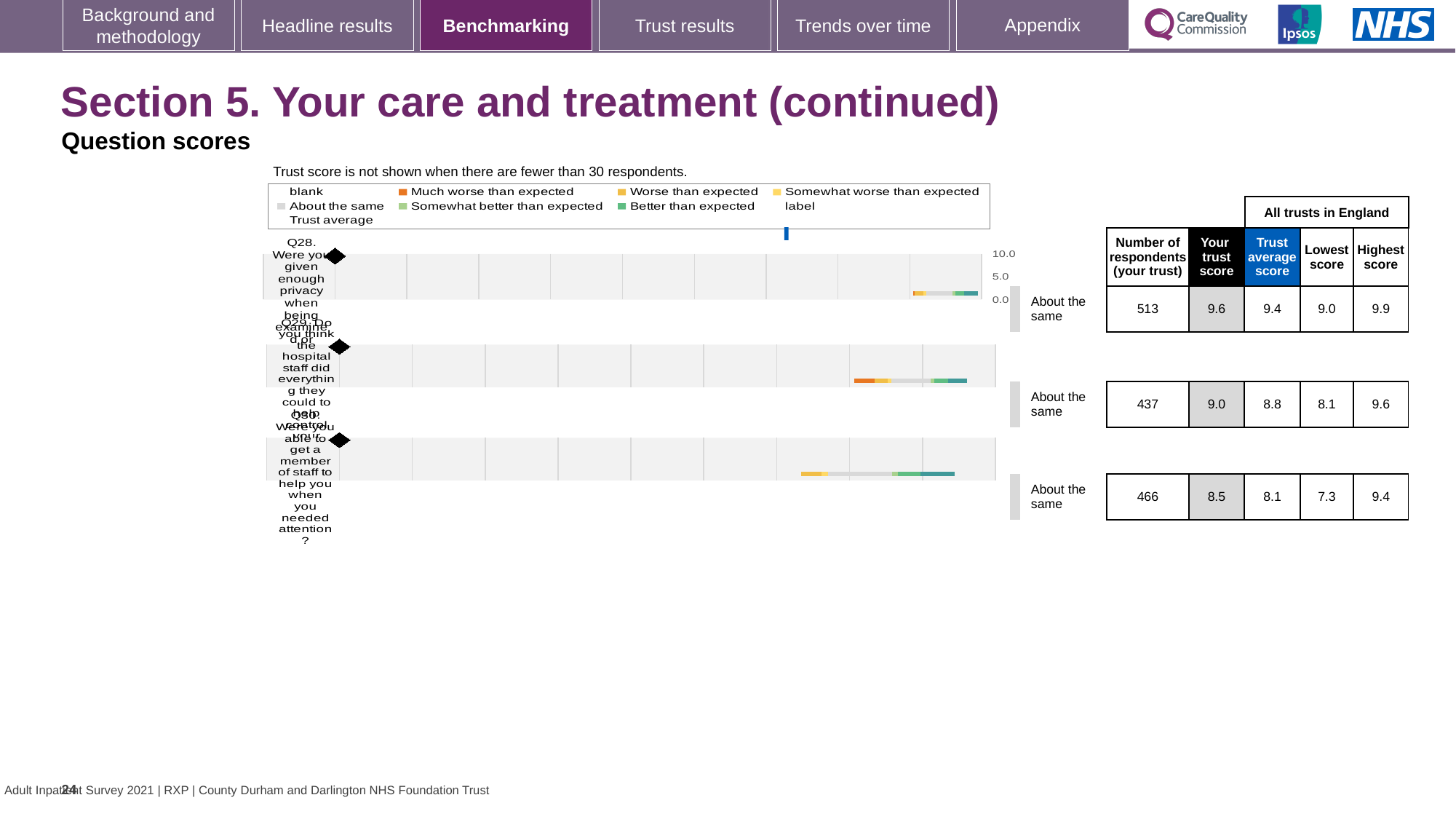
What is the difference between the 'Your trust score' and the 'Trust average score' for Q28? 0.2 What kind of chart is used to show the question scores on this slide? bar chart Which question has the lowest number of respondents? Q29 How many respondents are shown for Q29? 437 For Q30, which is larger: the 'Your trust score' or the 'Trust average score'? Your trust score Is the 'Your trust score' for Q30 greater or less than 5.0 on the chart axis? greater What is the 'Your trust score' value for Q28? 9.6 What benchmark category is shown next to the Q29 chart? About the same What is the 'Highest score' across all trusts in England for Q28? 9.9 What is the 'Trust average score' for Q30? 8.1 Which question has the highest 'Your trust score'? Q28 How many questions (Q28, Q29, Q30) are plotted on the slide? 3